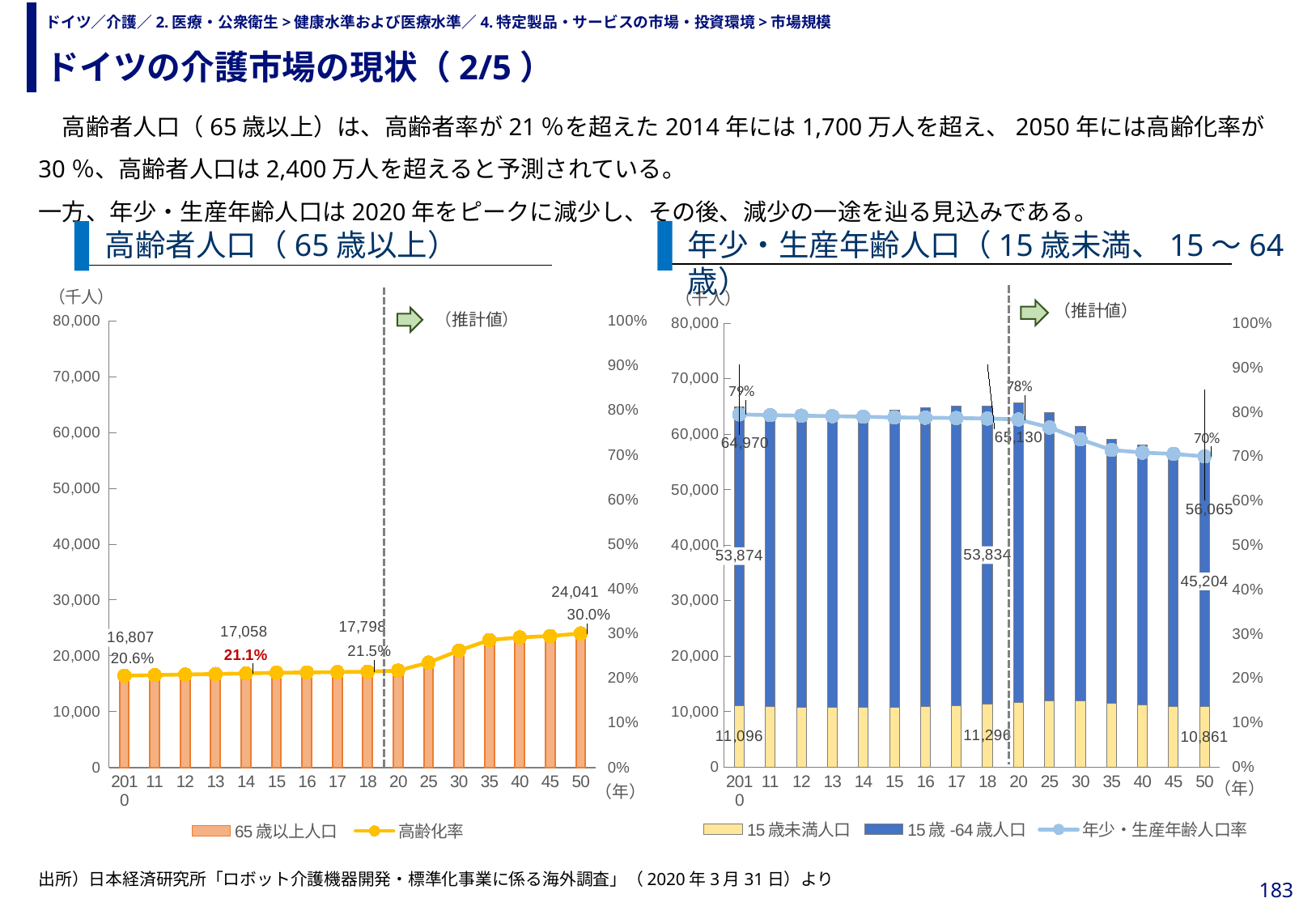
What kind of chart is the 高齢者人口（65歳以上） chart? Bar chart with a line In the 年少・生産年齢人口 chart, what is the difference between the 15歳-64歳人口 values for 2010 and 2050? 8,670 How many series does the legend of the 年少・生産年齢人口 chart list? 3 In the 年少・生産年齢人口 chart, which year has the larger 15歳-64歳人口 value, 2010 or 2050? 2010 In the 高齢者人口（65歳以上） chart, what is the 高齢化率 for 2014? 21.1% In the 高齢者人口（65歳以上） chart, is the 65歳以上人口 bar for 2040 greater or less than 20,000? greater How many years are shown on the x axis of the 高齢者人口（65歳以上） chart? 16 In the 年少・生産年齢人口 chart, what is the total of the stacked bar for 2050? 56,065 In the 高齢者人口（65歳以上） chart, what is the 65歳以上人口 value for 2050? 24,041 In the 年少・生産年齢人口 chart, what is the 15歳未満人口 value for 2018? 11,296 In the 高齢者人口（65歳以上） chart, does the 高齢化率 line rise or fall from 2010 to 2050? Rise In the 高齢者人口（65歳以上） chart, what is the difference between the 65歳以上人口 values for 2050 and 2010? 7,234